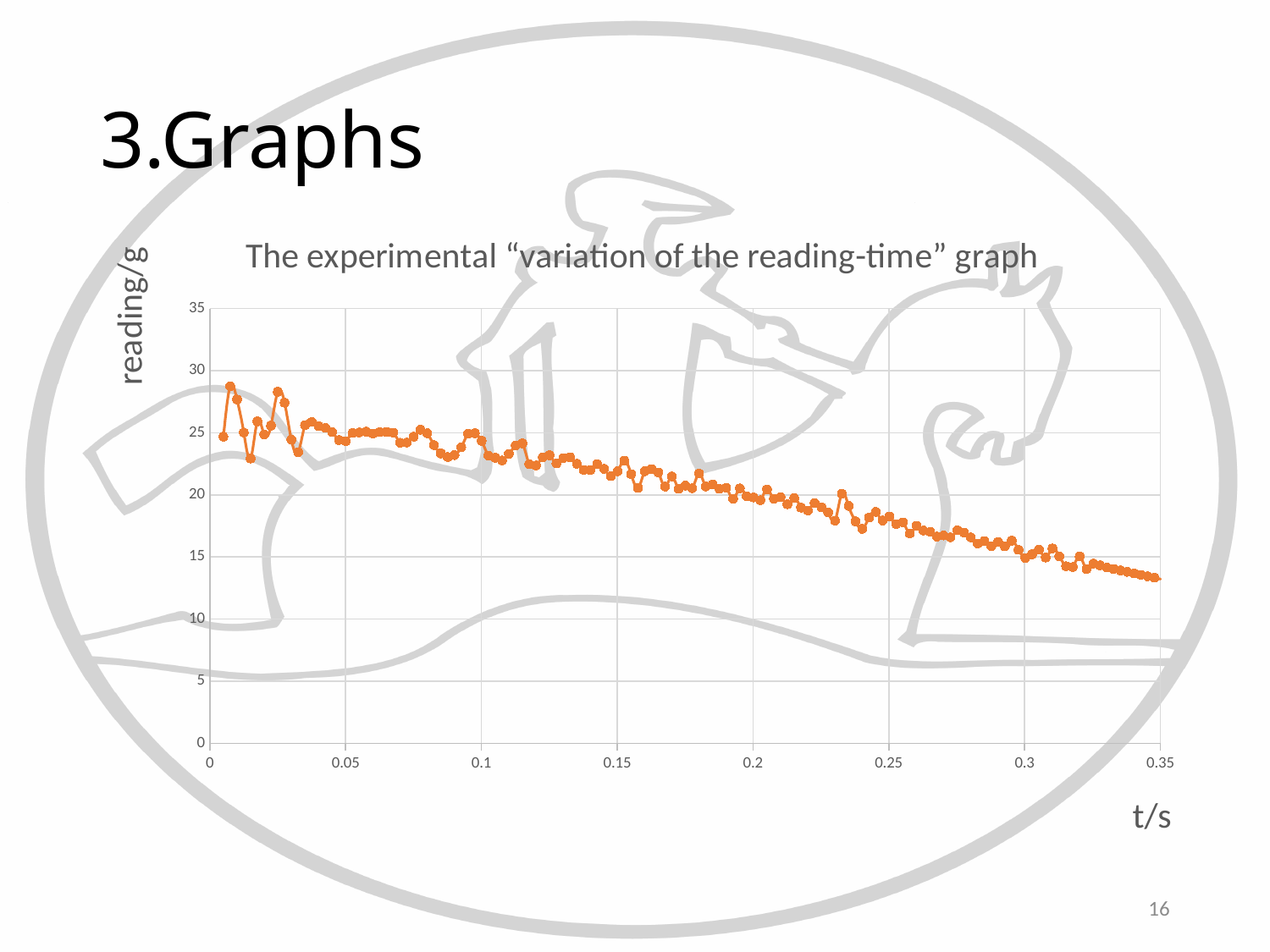
What is the label of the vertical axis of the chart? reading/g Is the value of the plotted point at t/s = 0.25 greater or less than 20? less What is the title of the chart? The experimental "variation of the reading-time" graph Is the highest plotted value on the chart greater or less than 25? greater Is the value of the plotted point at t/s = 0.1 greater or less than 20? greater How many data series are plotted on the chart? 1 Do the plotted values generally rise or fall as t/s increases? fall What kind of chart is shown on the slide? line chart What is the maximum value shown on the vertical axis of the chart? 35